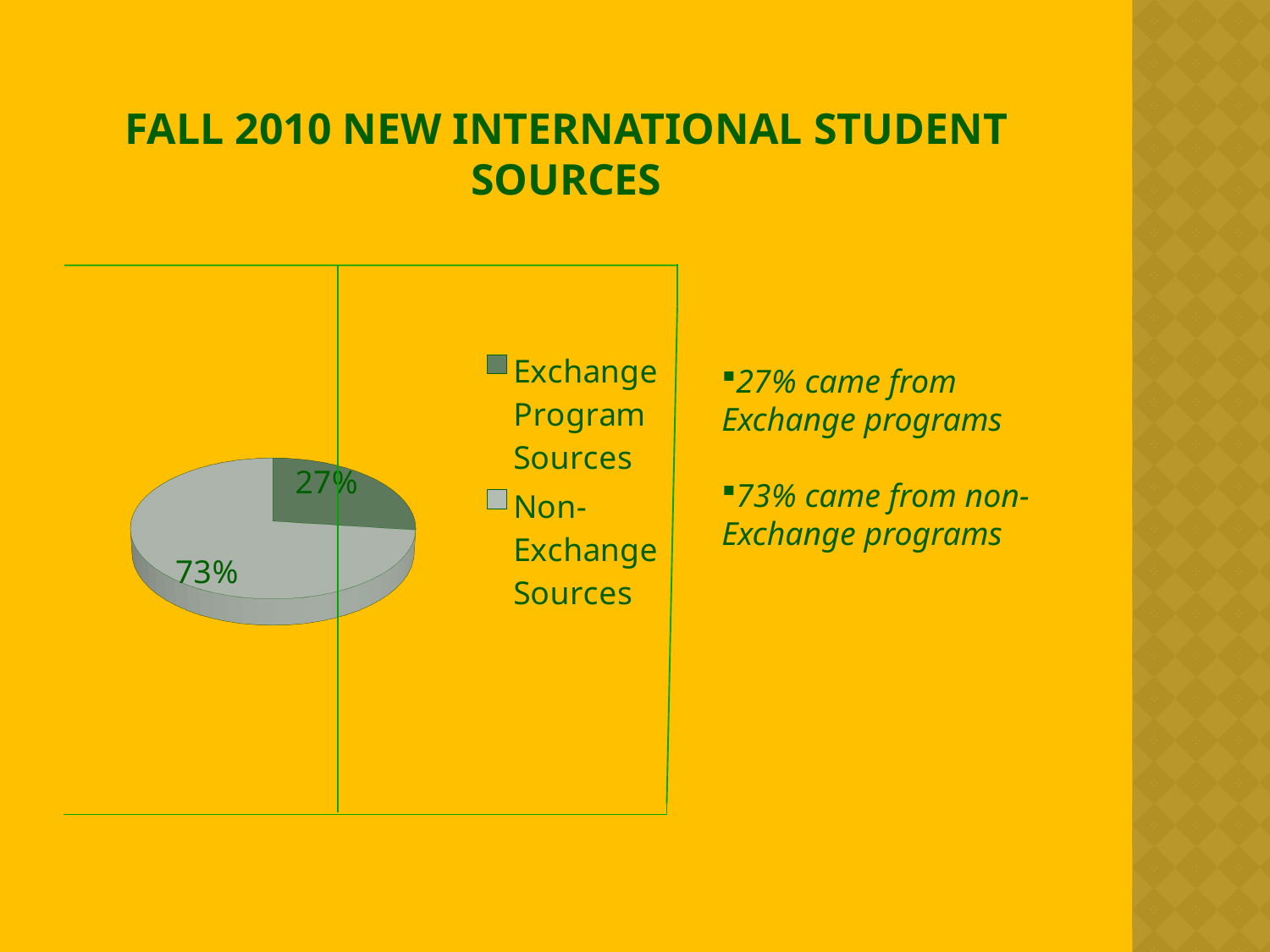
How many slices does the pie chart have? 2 What kind of chart is shown on the slide? pie chart What share of the pie is Exchange Program Sources? 27% What is the title of the slide containing the pie chart? FALL 2010 NEW INTERNATIONAL STUDENT SOURCES What is the difference in percentage points between the Non-Exchange Sources slice and the Exchange Program Sources slice? 46 What share of the pie is Non-Exchange Sources? 73% Which slice of the pie is the smallest? Exchange Program Sources How many entries does the legend list? 2 Which legend entry is shown in the darker green colour? Exchange Program Sources Which is larger: the Exchange Program Sources slice or the Non-Exchange Sources slice? Non-Exchange Sources Which slice of the pie is the largest? Non-Exchange Sources